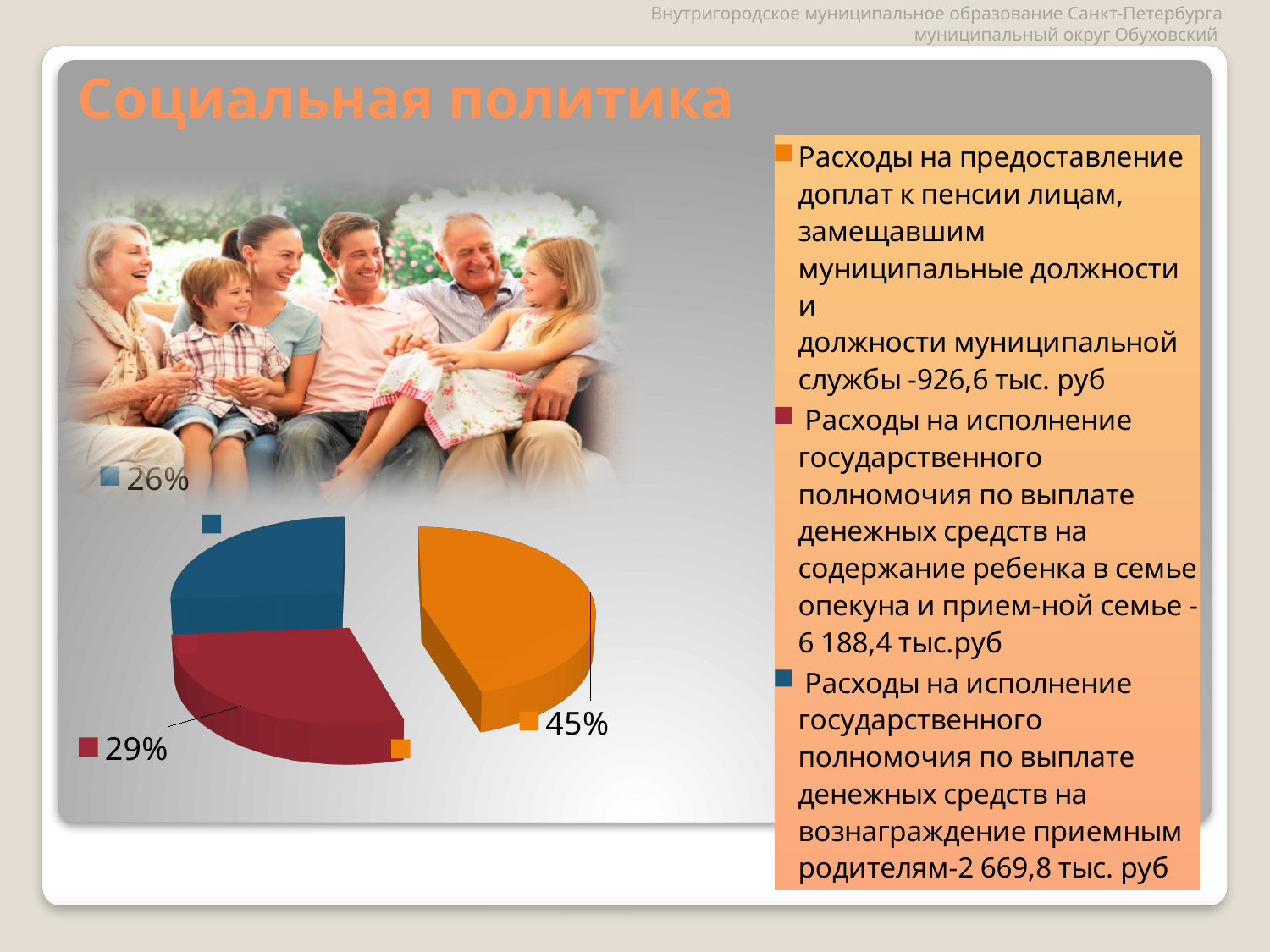
Which is larger, the red slice or the blue slice? The red slice How many slices does the pie chart have? 3 What percentage is shown for the red slice of the pie chart? 29% What do the three percentages on the pie chart add up to? 100% What kind of chart is shown on the slide? Pie chart By how many percentage points does the orange slice exceed the red slice? 16 percentage points What percentage is shown for the blue slice of the pie chart? 26% By how many percentage points does the red slice exceed the blue slice? 3 percentage points Which slice of the pie chart is the smallest? The blue slice (26%) What percentage is shown for the orange slice of the pie chart? 45% Which slice of the pie chart is the largest? The orange slice (45%) What is the title of the slide containing the pie chart? Социальная политика